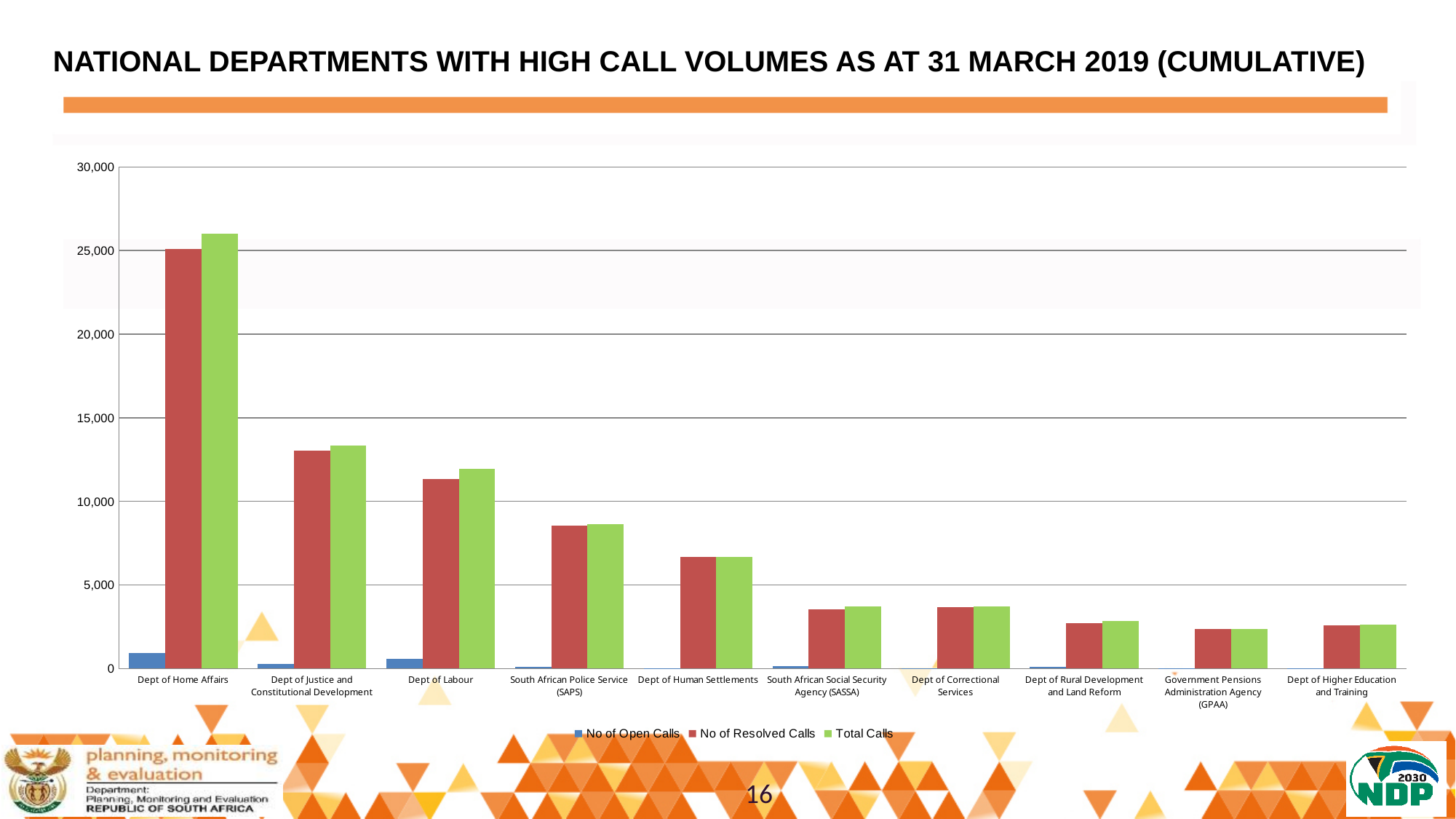
Which department has the highest number of open calls? Dept of Home Affairs Is the No of Resolved Calls value for Dept of Human Settlements greater or less than 5,000? greater Is the Total Calls value for Dept of Labour greater or less than 10,000? greater What type of chart is shown on the slide? Bar chart Which department has the highest Total Calls? Dept of Home Affairs What is the title of the chart on the slide? NATIONAL DEPARTMENTS WITH HIGH CALL VOLUMES AS AT 31 MARCH 2019 (CUMULATIVE) Do the Total Calls values generally rise or fall moving from left to right across the departments? Fall How many departments are shown on the x axis of the chart? 10 How many series does the chart legend list? 3 Which has more Total Calls: Dept of Justice and Constitutional Development or Dept of Labour? Dept of Justice and Constitutional Development Is the Total Calls value for South African Police Service (SAPS) greater or less than 10,000? less